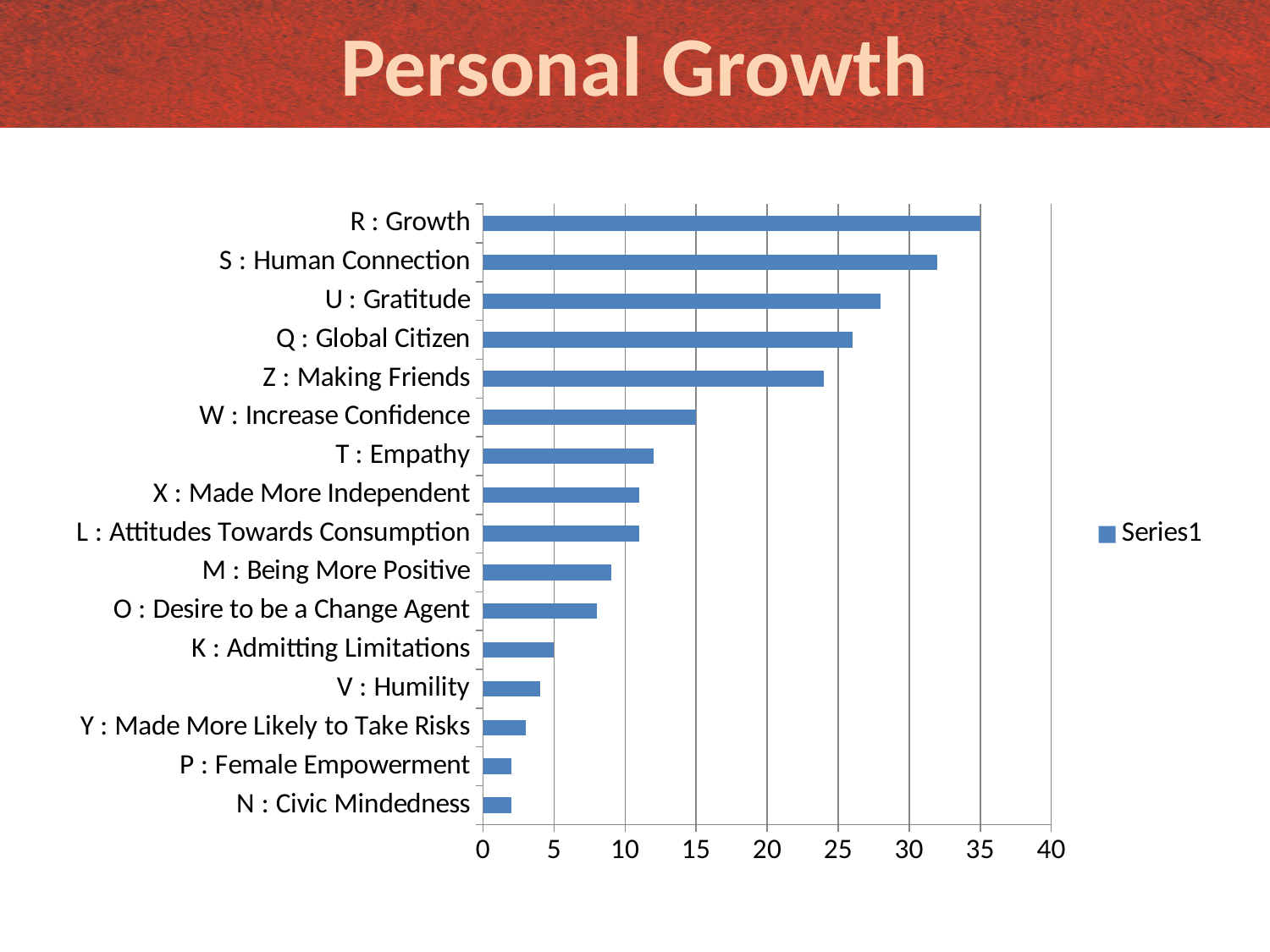
What is the value for R : Growth? 35 Is the value for V : Humility greater or less than 5? less What is the value for K : Admitting Limitations? 5 Which category has the highest value? R : Growth Is the value for Z : Making Friends greater or less than 20? greater What is the value for W : Increase Confidence? 15 Which is larger, the value for S : Human Connection or the value for U : Gratitude? S : Human Connection What is the title of the slide containing the chart? Personal Growth Is the value for M : Being More Positive greater or less than 10? less What type of chart is shown on the slide? bar chart How many series does the legend list? 1 How many categories are plotted in the chart? 16